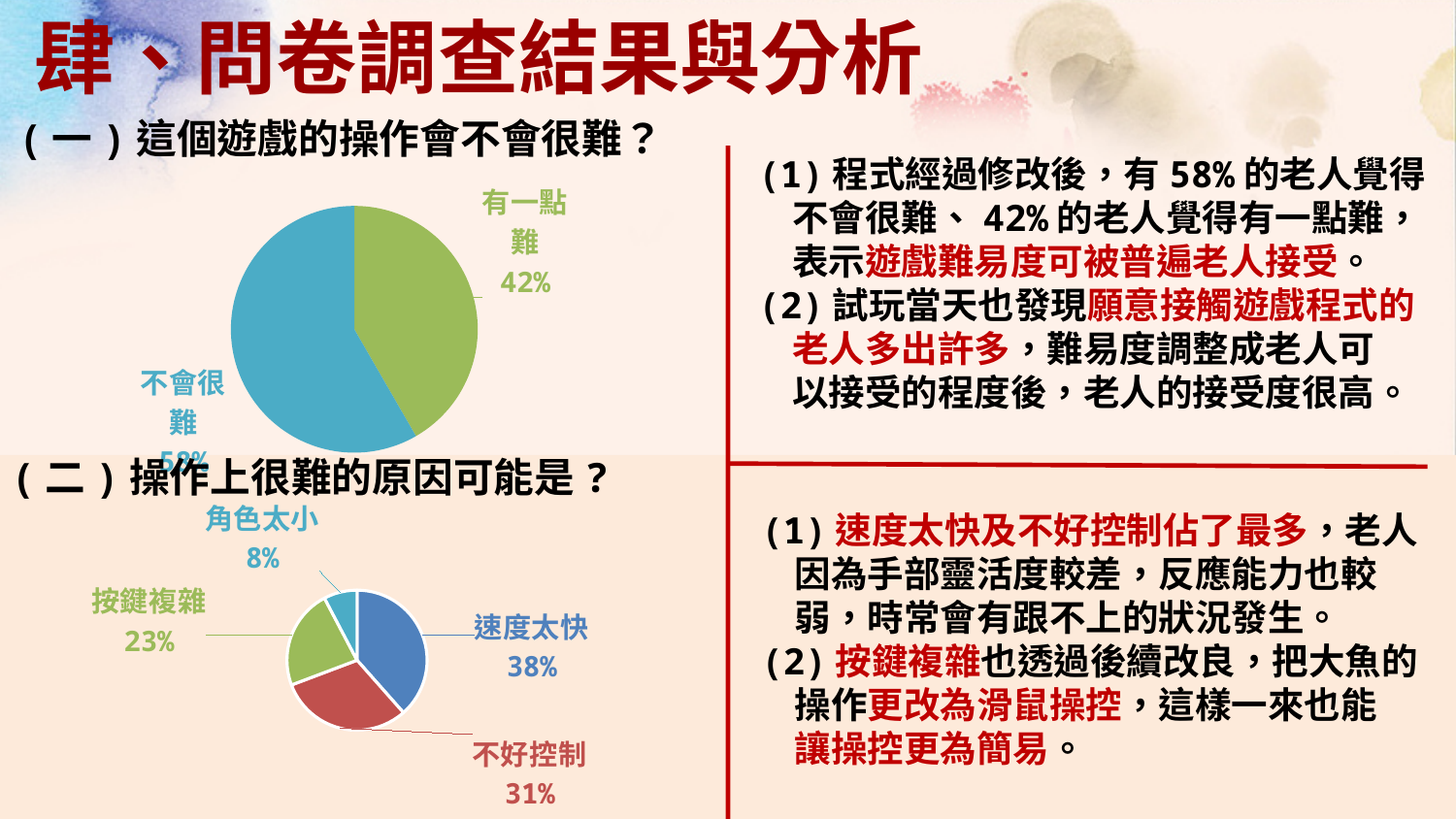
In the bottom pie chart (操作上很難的原因可能是？), what is the share for 不好控制? 31% What type of chart is used for 操作上很難的原因可能是？ at the bottom left of the slide? Pie chart In the top pie chart (這個遊戲的操作會不會很難？), what percentage of respondents answered 有一點難? 42% In the top pie chart (這個遊戲的操作會不會很難？), how many slices are there? 2 In the top pie chart (這個遊戲的操作會不會很難？), which response has the larger share? 不會很難 In the top pie chart (這個遊戲的操作會不會很難？), what percentage of respondents answered 不會很難? 58% In the bottom pie chart (操作上很難的原因可能是？), which reason has the largest share? 速度太快 In the bottom pie chart (操作上很難的原因可能是？), which reason has the smallest share? 角色太小 In the bottom pie chart (操作上很難的原因可能是？), what is the difference in percentage points between 速度太快 and 角色太小? 30 In the bottom pie chart (操作上很難的原因可能是？), what is the share for 速度太快? 38% In the bottom pie chart (操作上很難的原因可能是？), how many categories are shown? 4 In the bottom pie chart (操作上很難的原因可能是？), what is the share for 按鍵複雜? 23%